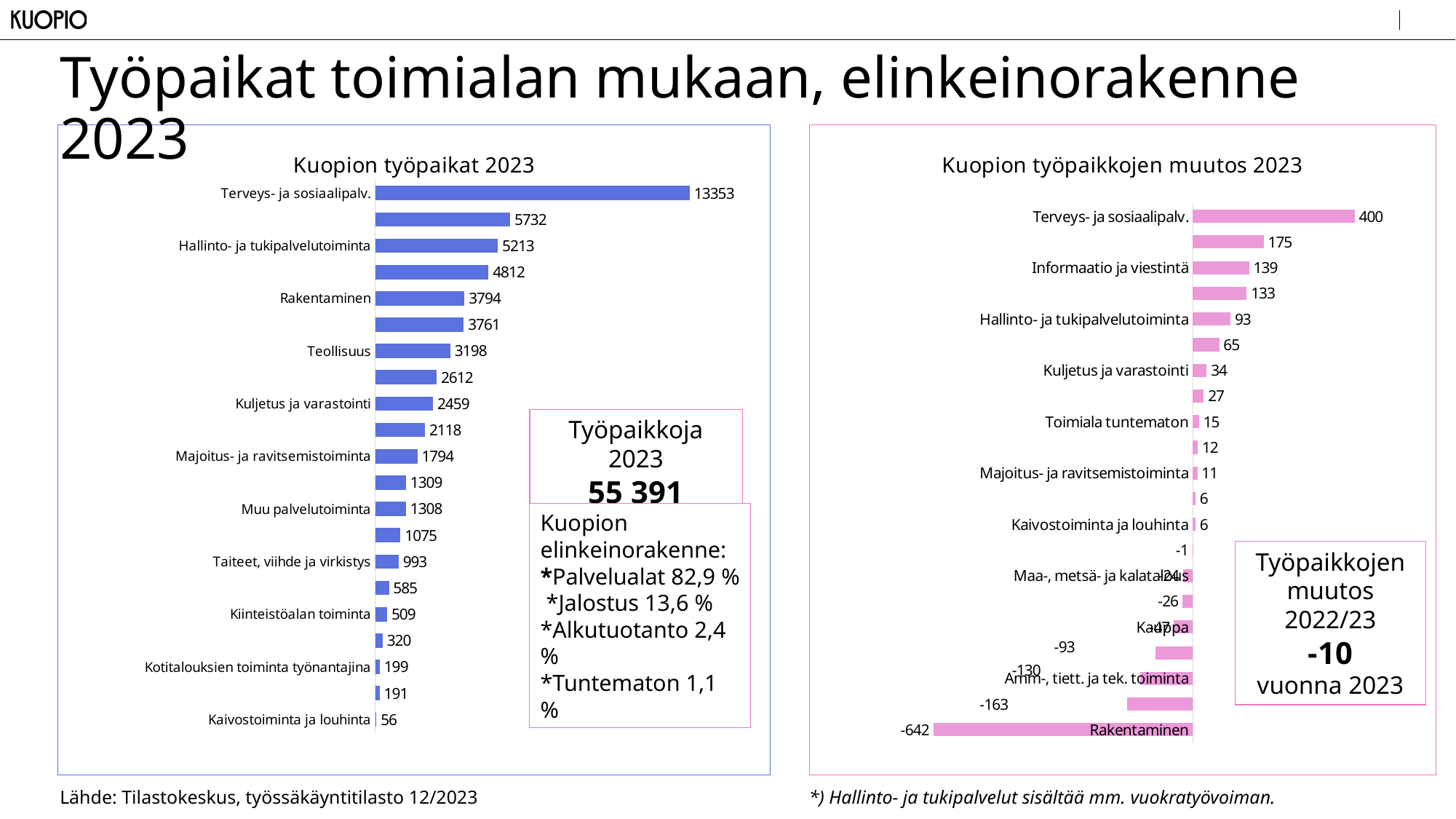
In the chart 'Kuopion työpaikat 2023', what is the value for Terveys- ja sosiaalipalv.? 13353 What is the title of the chart on the left side of the slide? Kuopion työpaikat 2023 In the chart 'Kuopion työpaikkojen muutos 2023', what is the value for Informaatio ja viestintä? 139 In the chart 'Kuopion työpaikkojen muutos 2023', which category has the lowest value? Rakentaminen In the chart 'Kuopion työpaikat 2023', which category has the highest value? Terveys- ja sosiaalipalv. In the chart 'Kuopion työpaikat 2023', how many bars are plotted? 21 In the chart 'Kuopion työpaikkojen muutos 2023', what is the value for Rakentaminen? -642 In the chart 'Kuopion työpaikat 2023', what is the value for Kaivostoiminta ja louhinta? 56 What type of chart is 'Kuopion työpaikkojen muutos 2023'? Bar chart In the chart 'Kuopion työpaikat 2023', what is the value for Rakentaminen? 3794 In the chart 'Kuopion työpaikat 2023', what is the difference between Hallinto- ja tukipalvelutoiminta and Teollisuus? 2015 In the chart 'Kuopion työpaikat 2023', which is larger, Kuljetus ja varastointi or Majoitus- ja ravitsemistoiminta? Kuljetus ja varastointi